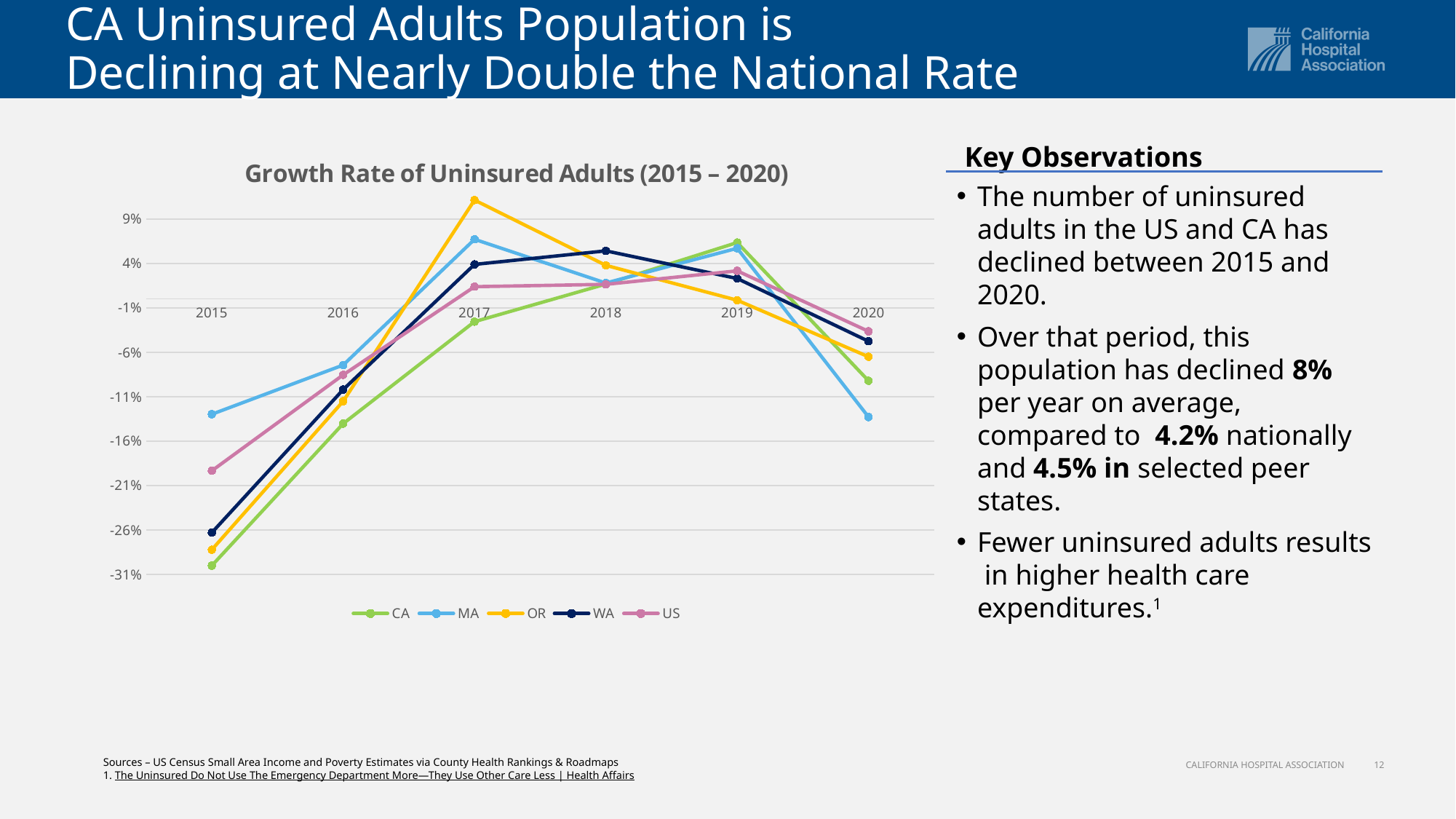
Is the value for CA in 2015 greater or less than -26%? less Which series has the highest value in 2017? OR Is the value for OR in 2017 greater or less than 9%? greater Which series has the highest value in 2015? MA How many years are shown on the x axis of the chart? 6 What kind of chart is shown on the slide? line chart In 2015, which is larger, the value for MA or the value for US? MA How many series does the legend of the chart list? 5 Is the value for MA in 2020 greater or less than -11%? less What is the title of the chart? Growth Rate of Uninsured Adults (2015 – 2020) Does the CA line rise or fall from 2015 to 2017? rise Which series has the lowest value in 2020? MA